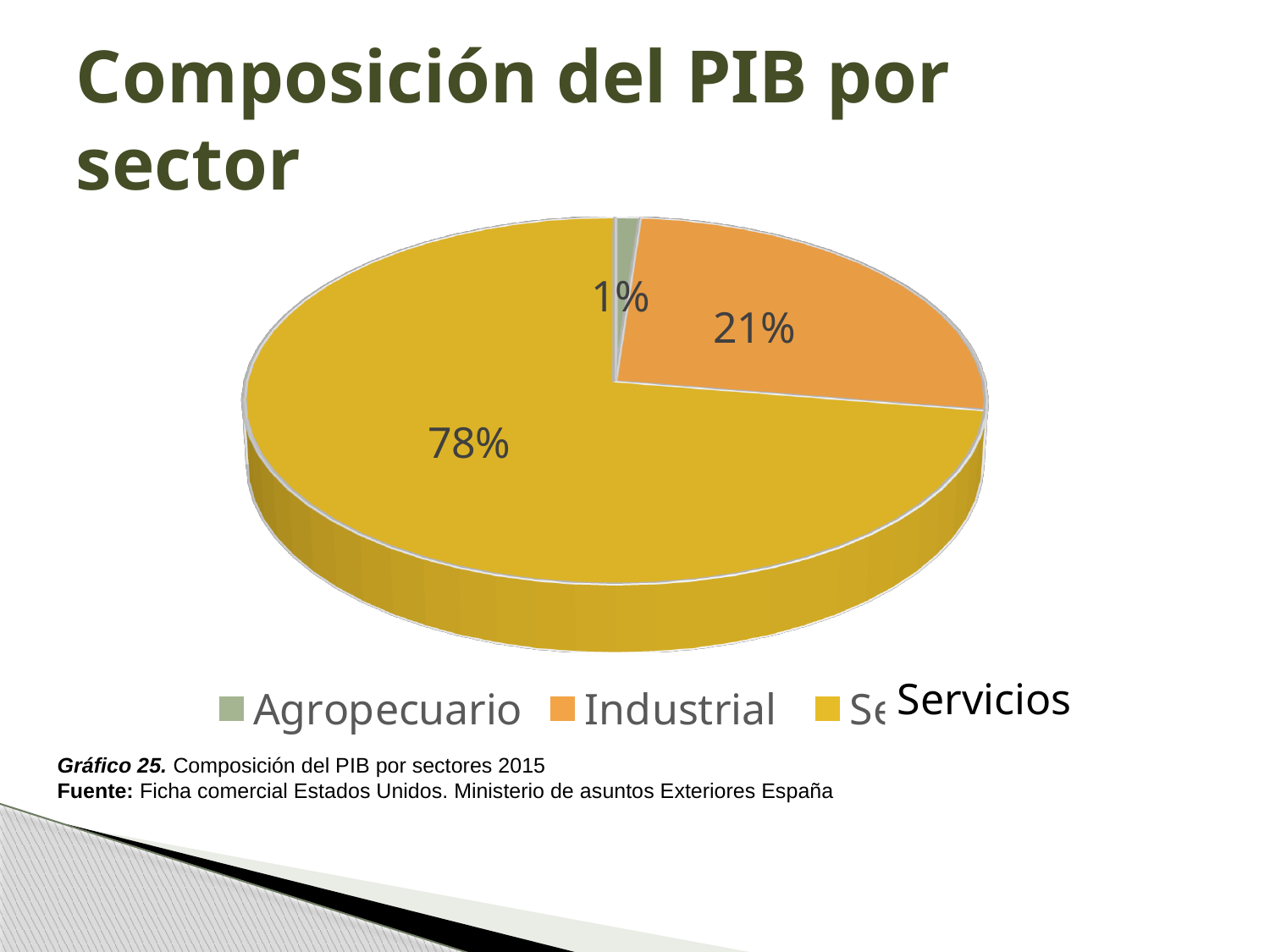
Which is larger, the share for Industrial or the share for Agropecuario? Industrial What share of the pie does Agropecuario represent? 1% What is the difference in percentage points between the Industrial and Agropecuario shares? 20 What kind of chart is shown on the slide? pie chart How many sectors are shown in the pie chart? 3 What colour is the Industrial slice of the pie? orange What year does the chart caption say the GDP composition refers to? 2015 What is the difference in percentage points between the Servicios and Industrial shares? 57 Which sector has the smallest share of the pie? Agropecuario Which sector has the largest share of the pie? Servicios What share of the pie does Industrial represent? 21% What share of the pie does Servicios represent? 78%